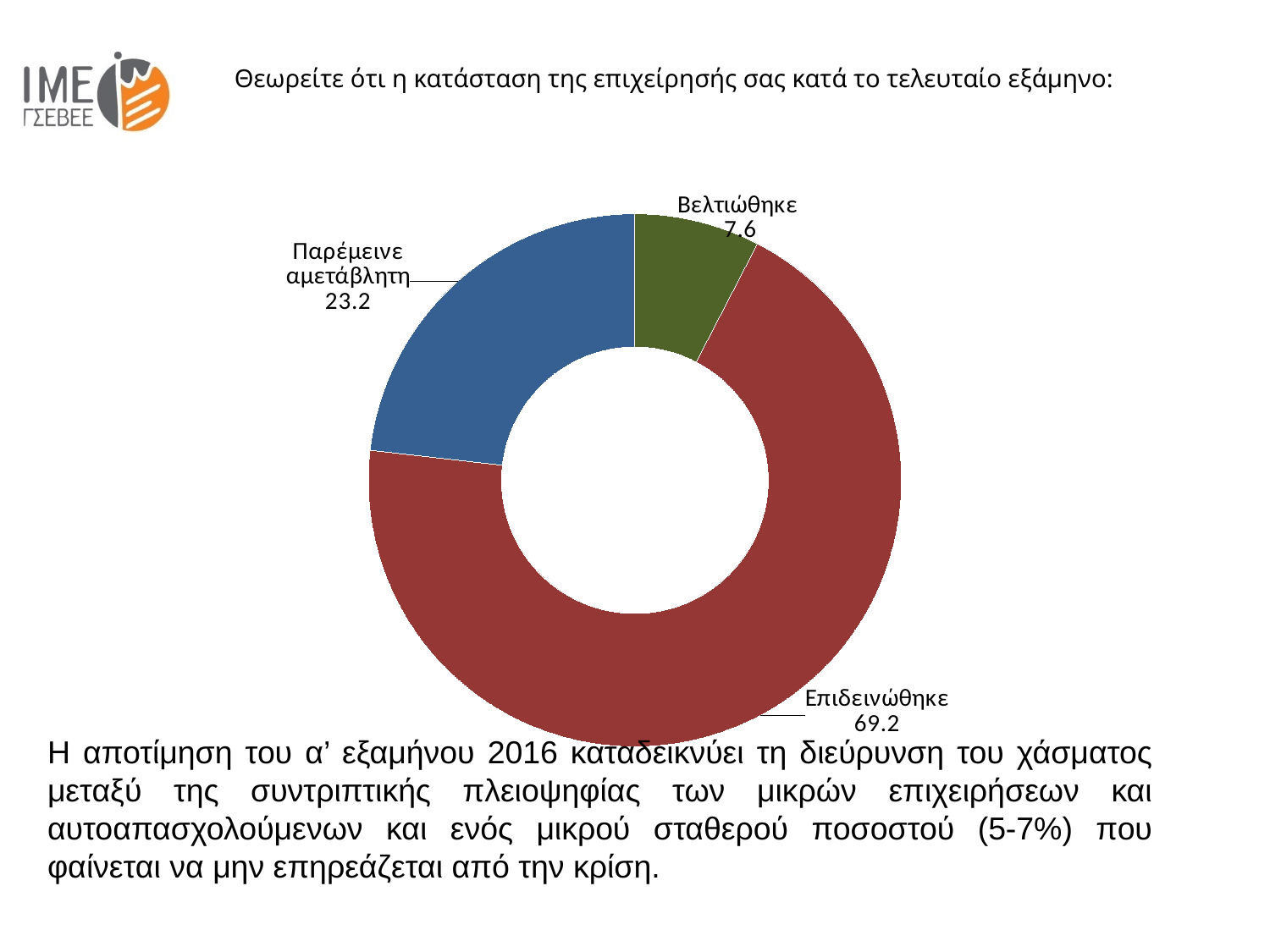
What is the total of the three values shown in the chart? 100 What is the difference between the values for Παρέμεινε αμετάβλητη and Βελτιώθηκε? 15.6 What value is shown for Βελτιώθηκε? 7.6 Which is larger, the value for Παρέμεινε αμετάβλητη or the value for Βελτιώθηκε? Παρέμεινε αμετάβλητη What value is shown for Επιδεινώθηκε? 69.2 What colour is the Επιδεινώθηκε segment? Red Which category has the smallest share of the chart? Βελτιώθηκε Which category has the largest share of the chart? Επιδεινώθηκε What kind of chart is shown on the slide? Doughnut (pie) chart What value is shown for Παρέμεινε αμετάβλητη? 23.2 What is the difference between the values for Επιδεινώθηκε and Παρέμεινε αμετάβλητη? 46 How many categories are shown in the chart? 3